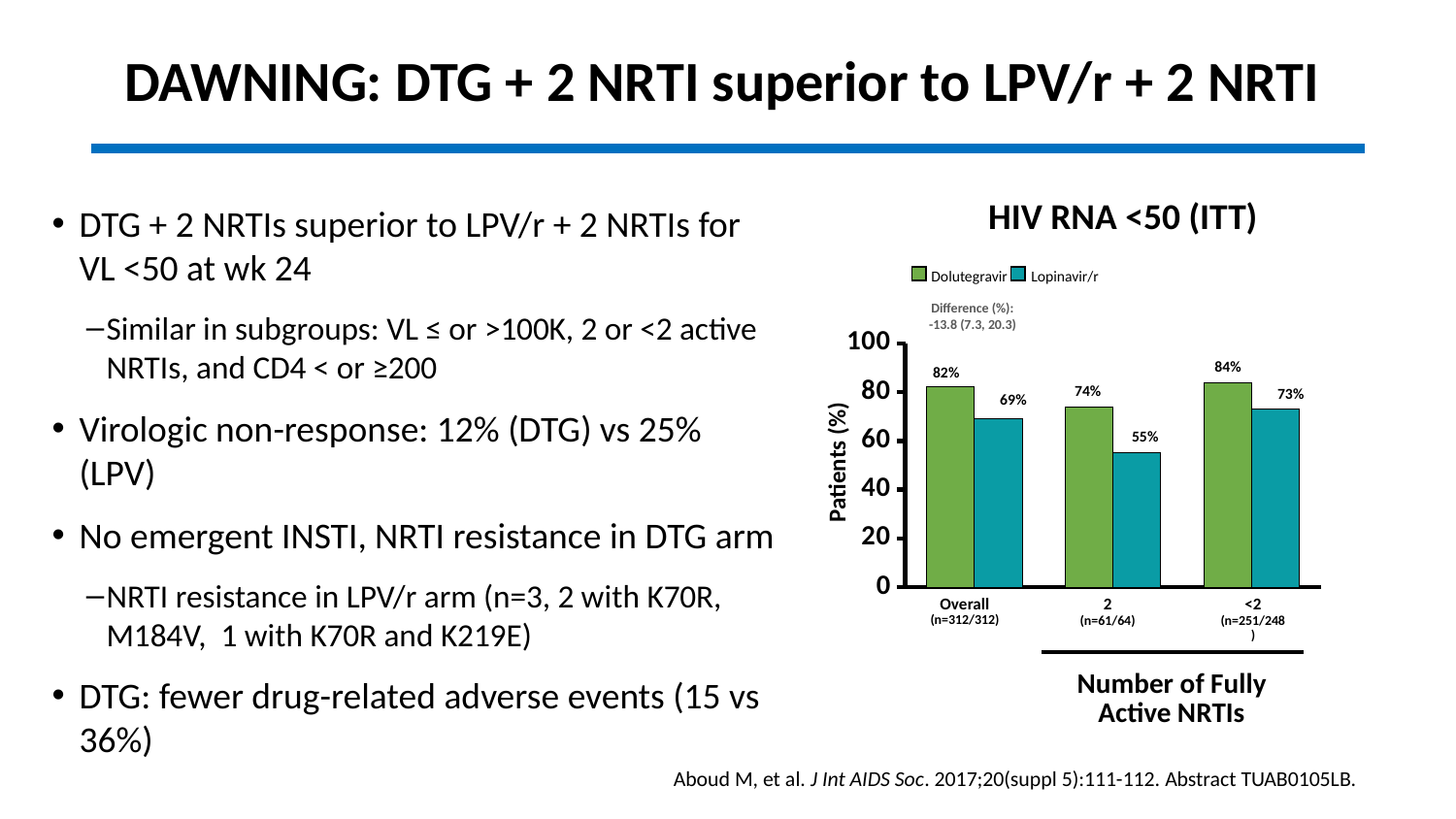
What is the label of the y axis? Patients (%) Which category has the highest Dolutegravir value? <2 What kind of chart is shown? Bar chart What is the value for Dolutegravir in the Overall category? 82% What is the difference between the Dolutegravir and Lopinavir/r values in the Overall category? 13 percentage points Which is larger in the 2 fully active NRTIs category, Dolutegravir or Lopinavir/r? Dolutegravir Which category has the lowest Lopinavir/r value? 2 What is the title of the chart? HIV RNA <50 (ITT) How many categories are shown on the x axis? 3 What is the value for Lopinavir/r in the <2 fully active NRTIs category? 73% How many series does the legend list? 2 What is the value for Lopinavir/r in the 2 fully active NRTIs category? 55%